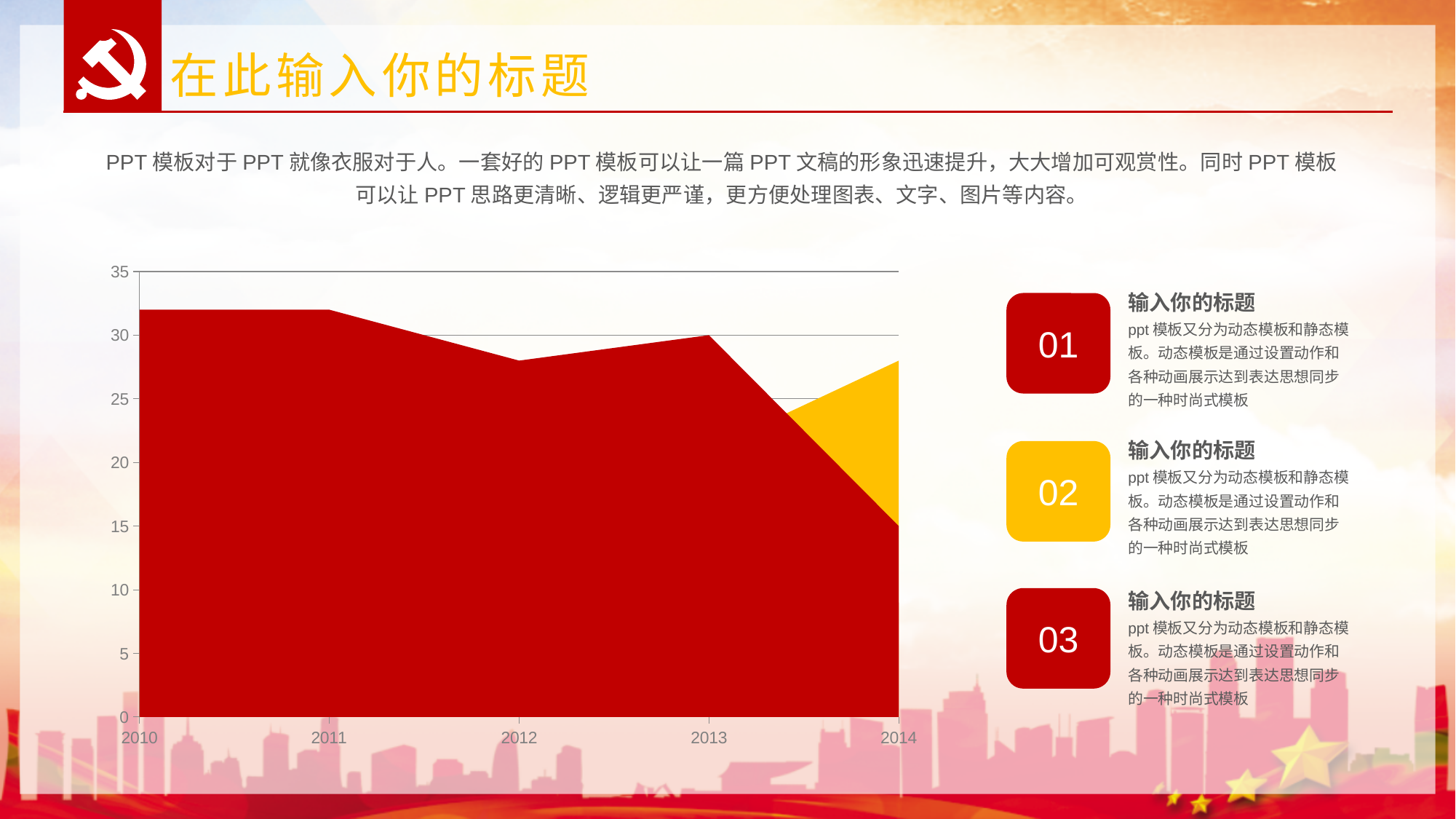
Is the value of the red series for 2012 greater or less than 25? greater At 2014, which series has the larger value, the red one or the yellow one? The yellow series What is the first year shown on the x axis of the chart? 2010 Which year has the lowest value for the red series? 2014 What is the highest value shown on the y axis of the chart? 35 How many years are shown on the x axis of the chart? 5 Is the value of the yellow series for 2014 greater or less than 25? greater Is the value of the red series for 2012 greater or less than 30? less What kind of chart is shown on the slide? Area chart Does the red series rise or fall from 2013 to 2014? Fall